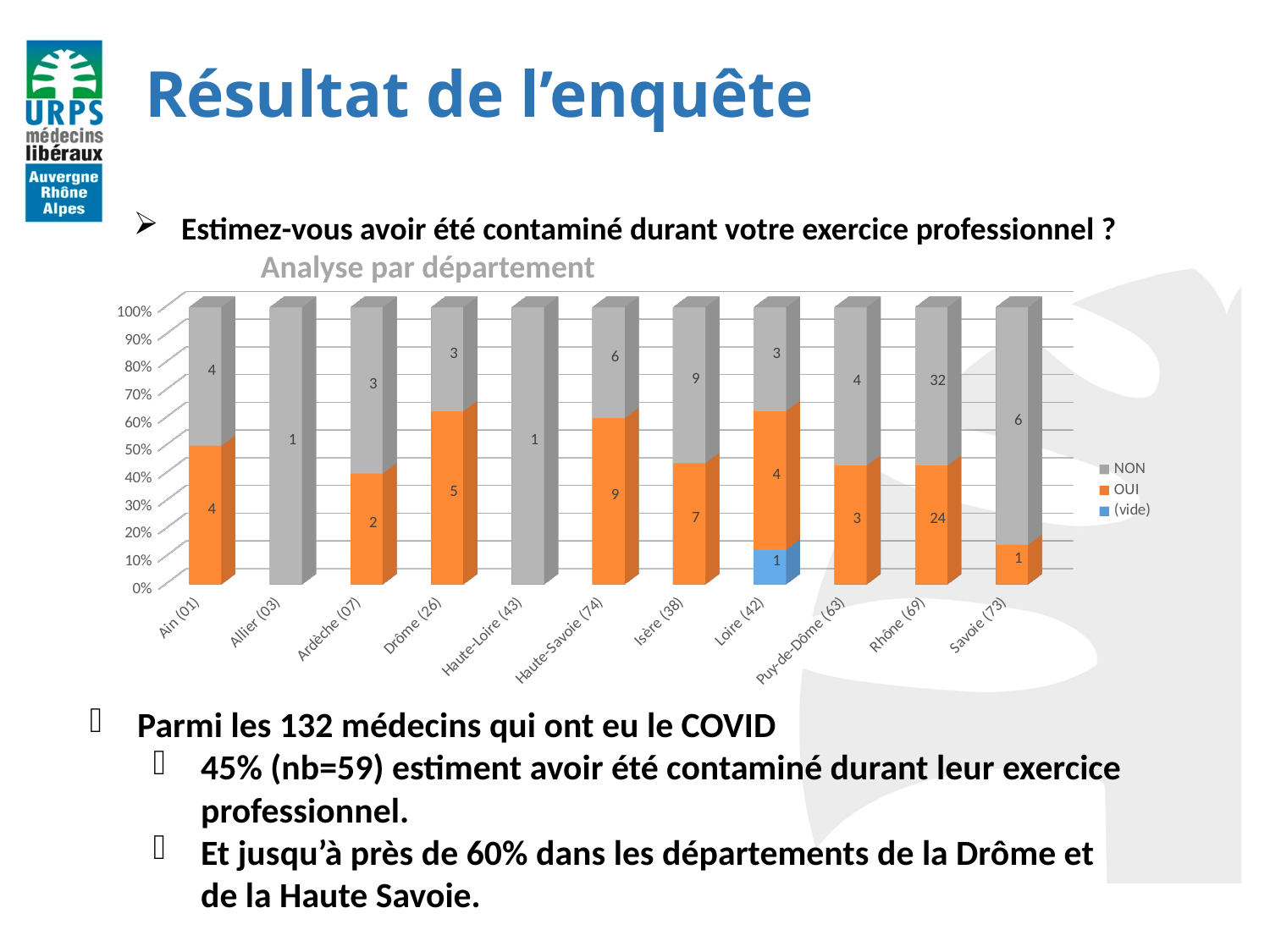
Is the OUI share of the bar for Savoie (73) greater or less than 20%? less What kind of chart is shown under 'Analyse par département'? Stacked bar chart What is the difference between the NON and OUI values for Isère (38)? 2 What is the (vide) value for Loire (42)? 1 What is the NON value for Rhône (69)? 32 What is the OUI value for Haute-Savoie (74)? 9 Which series is shown in orange in the chart? OUI How many departments are shown on the x axis of the chart? 11 How many series does the chart legend list? 3 Which is larger for Drôme (26), the OUI value or the NON value? OUI Which department has the highest OUI value? Rhône (69) What is the total number of responses (NON + OUI) for Rhône (69)? 56